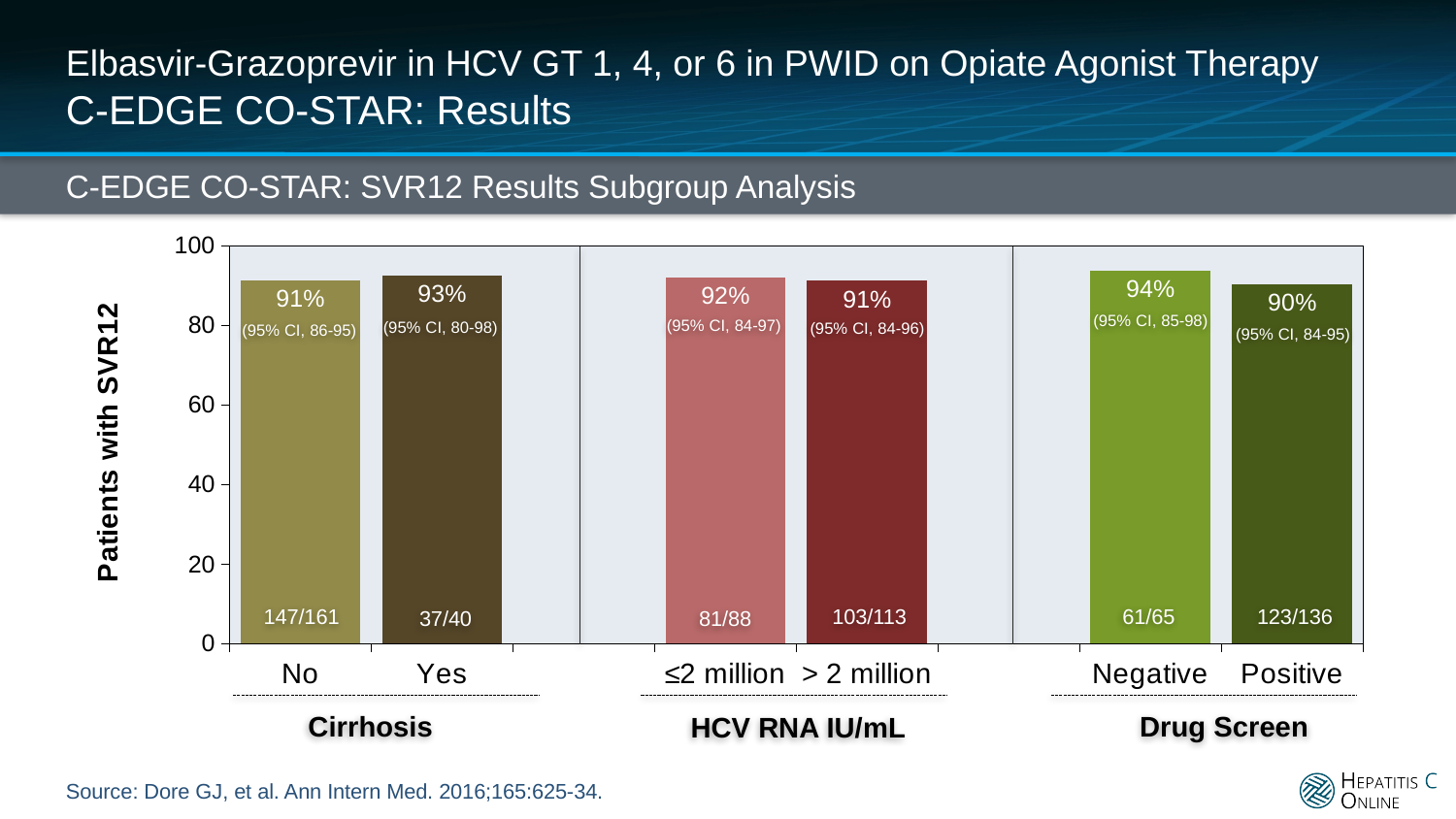
What is the SVR12 rate for patients with cirrhosis (Cirrhosis: Yes)? 93% How many bars are shown in the chart? 6 What is the SVR12 rate for patients without cirrhosis (Cirrhosis: No)? 91% What is the difference in SVR12 rate between the negative and positive drug screen groups? 4% What is the 95% confidence interval shown for the HCV RNA ≤2 million IU/mL group? 95% CI, 84-97 What is the SVR12 rate for patients with HCV RNA > 2 million IU/mL? 91% What type of chart is used to display the SVR12 subgroup results? Bar chart How many patients achieved SVR12 out of the total in the negative drug screen group, as labeled on the bar? 61/65 Which subgroup has the lowest SVR12 rate? Positive (Drug Screen) Which subgroup has the highest SVR12 rate? Negative (Drug Screen) Which has a higher SVR12 rate: patients with cirrhosis or patients without cirrhosis? Patients with cirrhosis (Yes) What is the SVR12 rate for patients with a positive drug screen? 90%